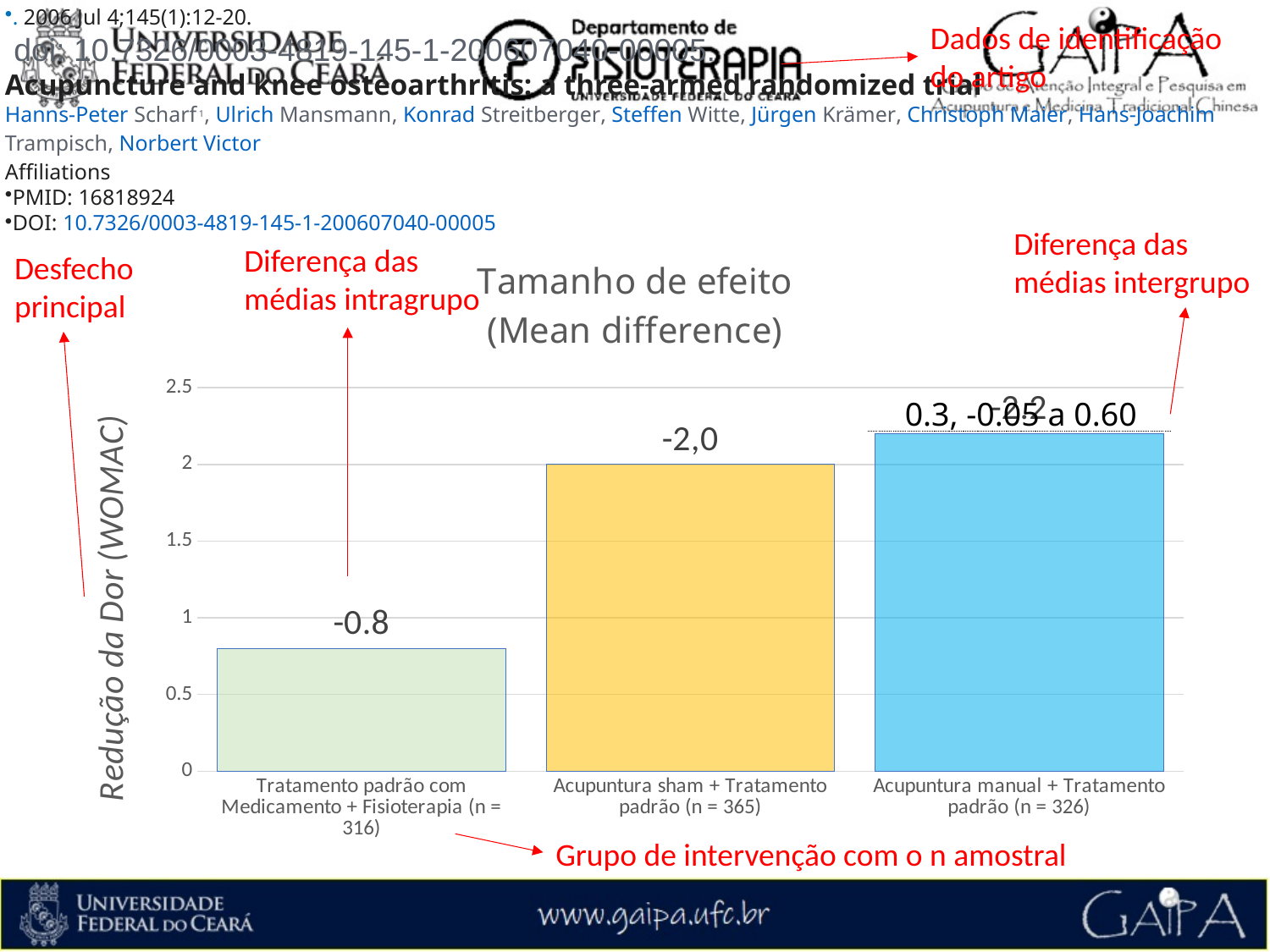
What is the value shown for the 'Tratamento padrão com Medicamento + Fisioterapia (n = 316)' bar? -0.8 What is the title of the chart? Tamanho de efeito (Mean difference) What type of chart is shown on the slide? Bar chart Which group has the tallest bar in the chart? Acupuntura manual + Tratamento padrão (n = 326) What is the sample size (n) given for the 'Acupuntura sham + Tratamento padrão' group? 365 Is the bar for 'Acupuntura manual + Tratamento padrão (n = 326)' greater or less than 2 on the axis? greater How many intervention groups (bars) are shown in the chart? 3 What is the value shown for the 'Acupuntura sham + Tratamento padrão (n = 365)' bar? -2,0 Is the bar for 'Tratamento padrão com Medicamento + Fisioterapia (n = 316)' greater or less than 1 on the axis? less What is the label of the vertical axis of the chart? Redução da Dor (WOMAC) Which bar is taller: 'Acupuntura sham + Tratamento padrão' or 'Tratamento padrão com Medicamento + Fisioterapia'? Acupuntura sham + Tratamento padrão Which group has the shortest bar in the chart? Tratamento padrão com Medicamento + Fisioterapia (n = 316)